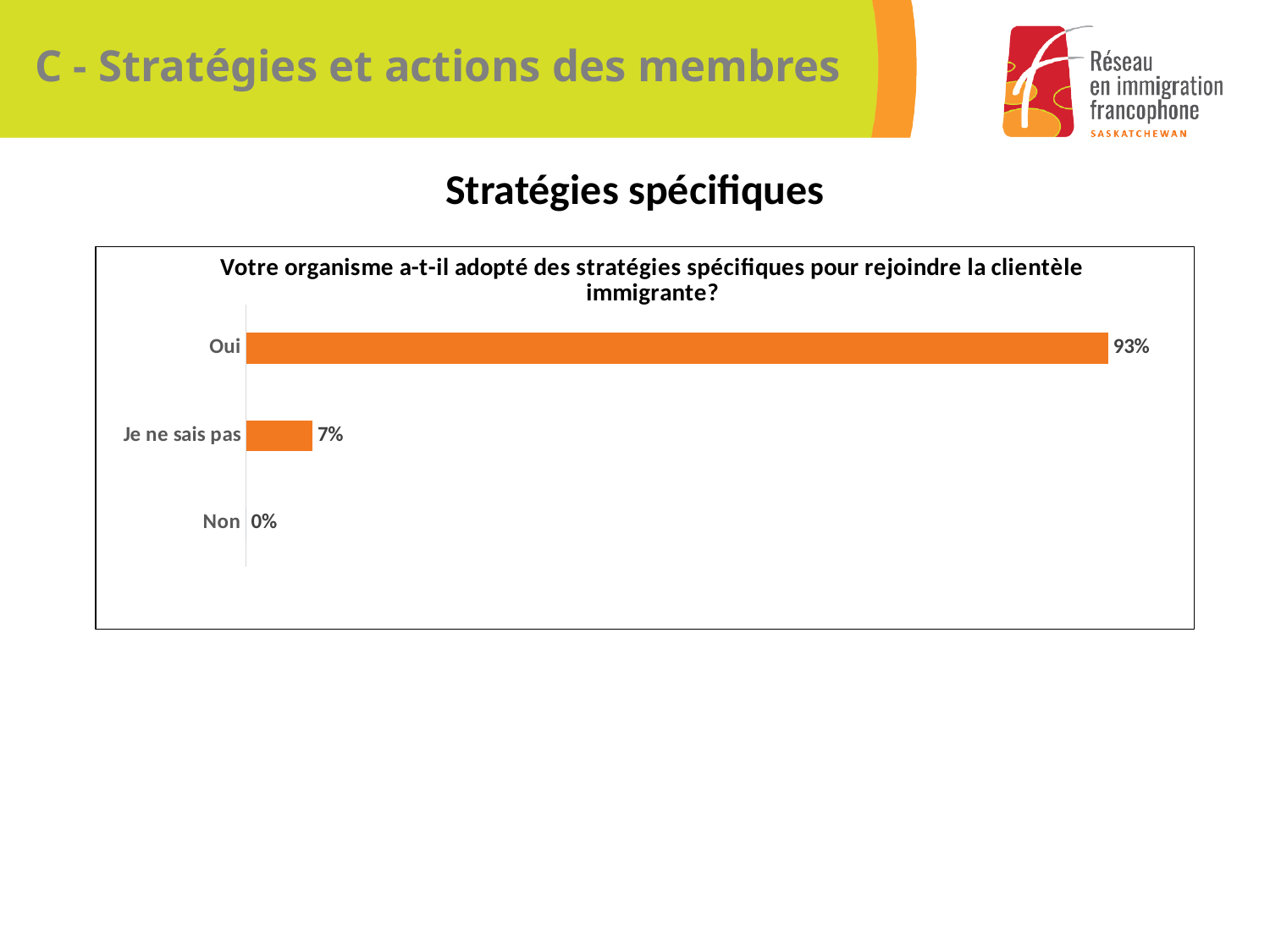
What is the title of the chart? Votre organisme a-t-il adopté des stratégies spécifiques pour rejoindre la clientèle immigrante? What is the difference between the values for "Oui" and "Je ne sais pas"? 86% Which is larger, the value for "Je ne sais pas" or the value for "Non"? Je ne sais pas How many categories are shown in the chart? 3 What is the value for "Non"? 0% Which category has the lowest value? Non What kind of chart is shown on the slide? Bar chart What is the value for "Je ne sais pas"? 7% What is the value for "Oui"? 93% What colour are the bars in the chart? Orange Which category has the highest value? Oui